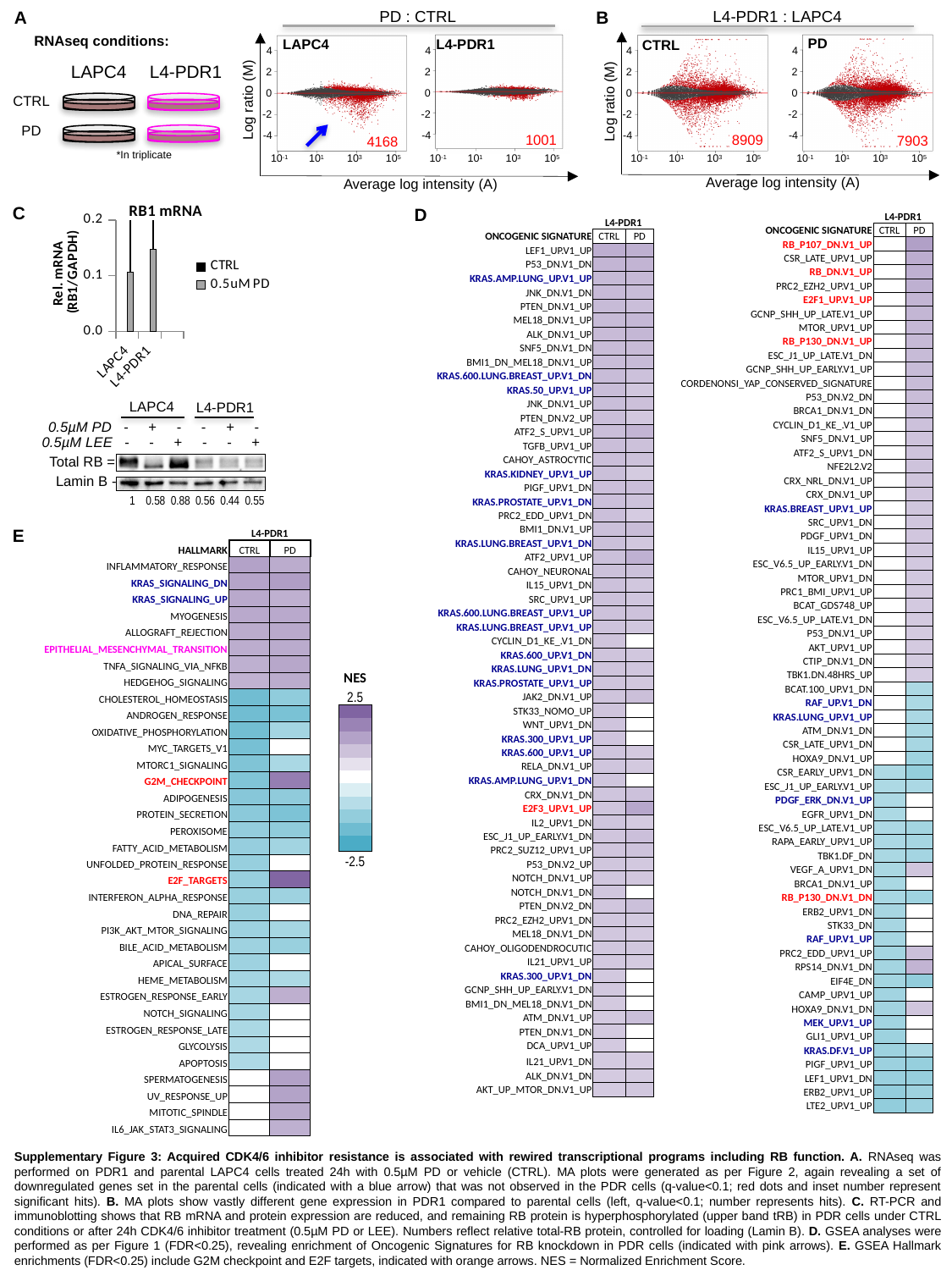
In panel B, what is the difference between the number of hits in the CTRL plot and the PD plot? 1006 In panel E, what are the top and bottom values shown on the NES colour scale? 2.5 and -2.5 In panel A, what is the difference between the number of hits in the LAPC4 plot and the L4-PDR1 plot? 3167 In panel B, what number is printed in the CTRL MA plot? 8909 In panel A, what number of significant hits is printed in the LAPC4 MA plot? 4168 How many series does the legend of the RB1 mRNA chart in panel C list? 2 In panel A, what number of significant hits is printed in the L4-PDR1 MA plot? 1001 In panel B, what number is printed in the PD MA plot? 7903 In panel A, which MA plot shows more significant hits, LAPC4 or L4-PDR1? LAPC4 What type of chart is the RB1 mRNA chart in panel C? bar chart In panel B, which MA plot shows more significant hits, CTRL or PD? CTRL In the RB1 mRNA chart in panel C, is the value for L4-PDR1 greater or less than 0.1? greater